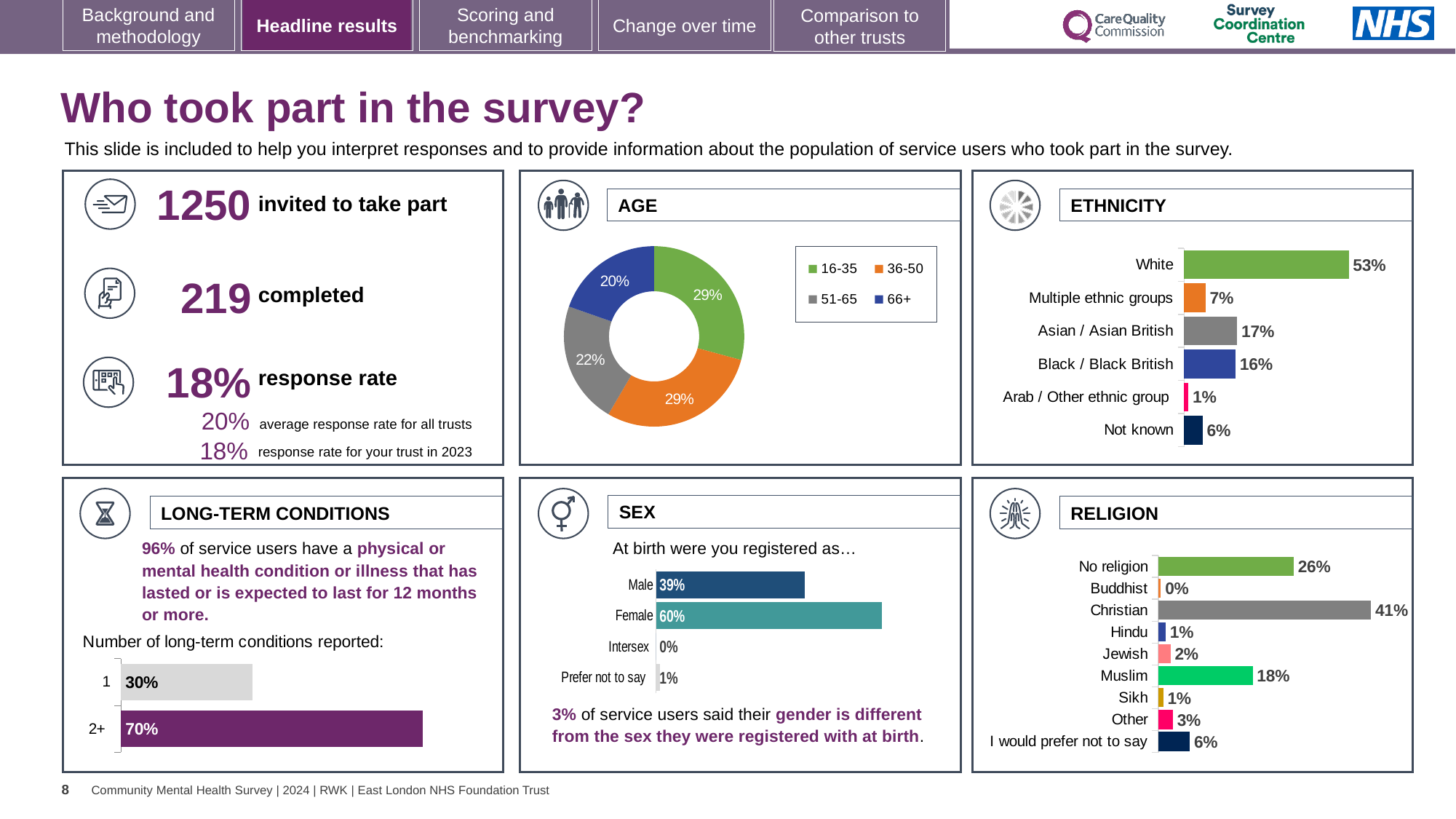
In the ETHNICITY chart, what is the value for Asian / Asian British? 17% In the ETHNICITY chart, how many categories are shown? 6 In the SEX chart, which is larger, Male or Female? Female In the AGE chart, how many age groups does the legend list? 4 In the AGE chart, what type of chart is used? Doughnut chart In the ETHNICITY chart, what is the difference between White and Black / Black British? 37% In the AGE chart, what percentage of respondents were aged 51-65? 22% In the RELIGION chart, which religion category has the highest percentage? Christian In the RELIGION chart, what is the value for Muslim? 18% In the ETHNICITY chart, which ethnic group has the highest percentage? White In the LONG-TERM CONDITIONS chart, what percentage reported 2+ long-term conditions? 70% In the SEX chart, what is the value for Prefer not to say? 1%